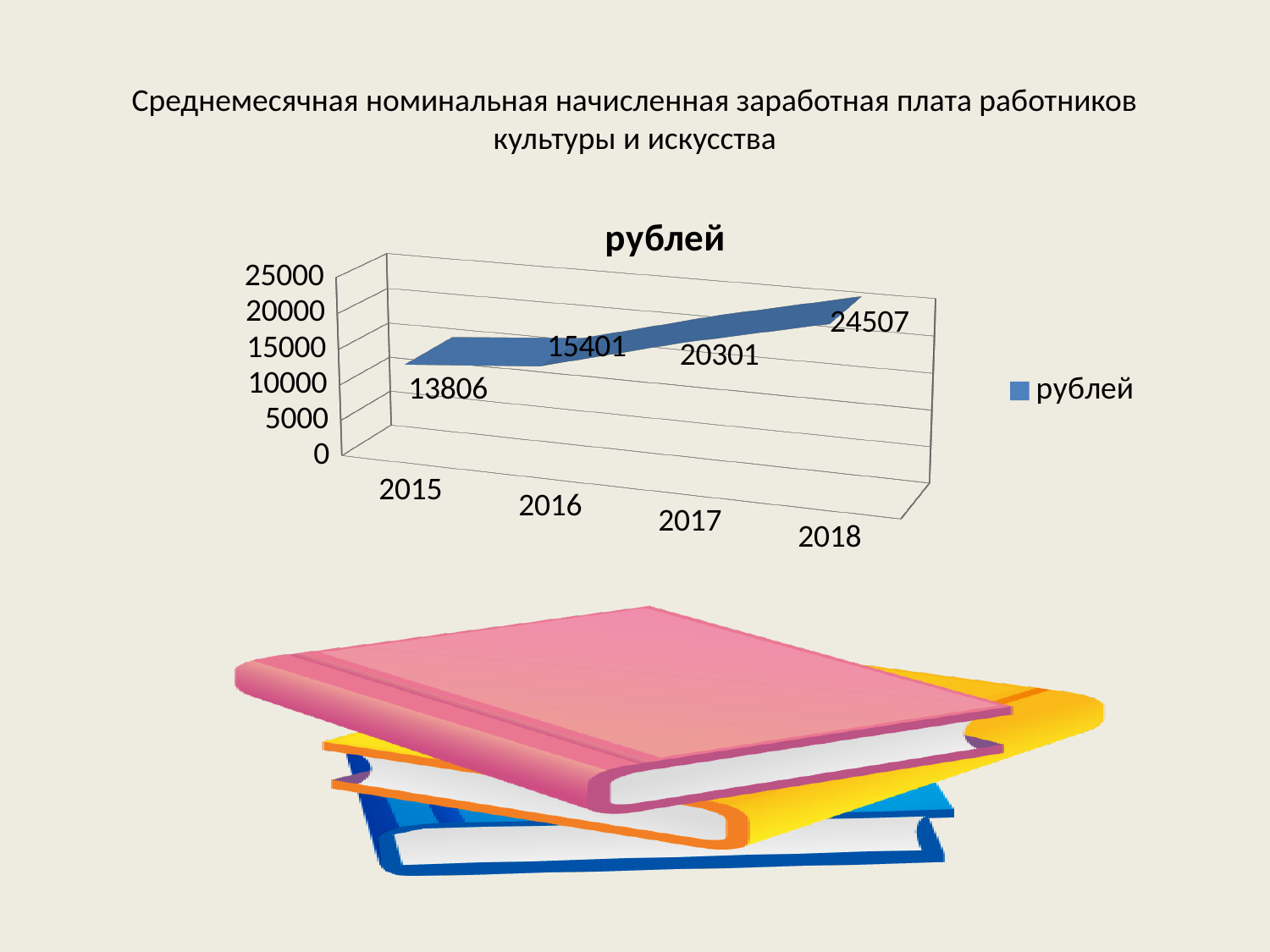
What is the difference between the values for 2018 and 2015? 10701 Which is larger, the value for 2016 or the value for 2017? 2017 What is the value for 2018? 24507 How many years are plotted on the chart? 4 What is the value for 2015? 13806 What is the value for 2016? 15401 What is the title of the chart? рублей Which year has the highest value? 2018 What is the difference between the values for 2017 and 2016? 4900 Do the values rise or fall from 2015 to 2018? rise What is the value for 2017? 20301 Which year has the lowest value? 2015